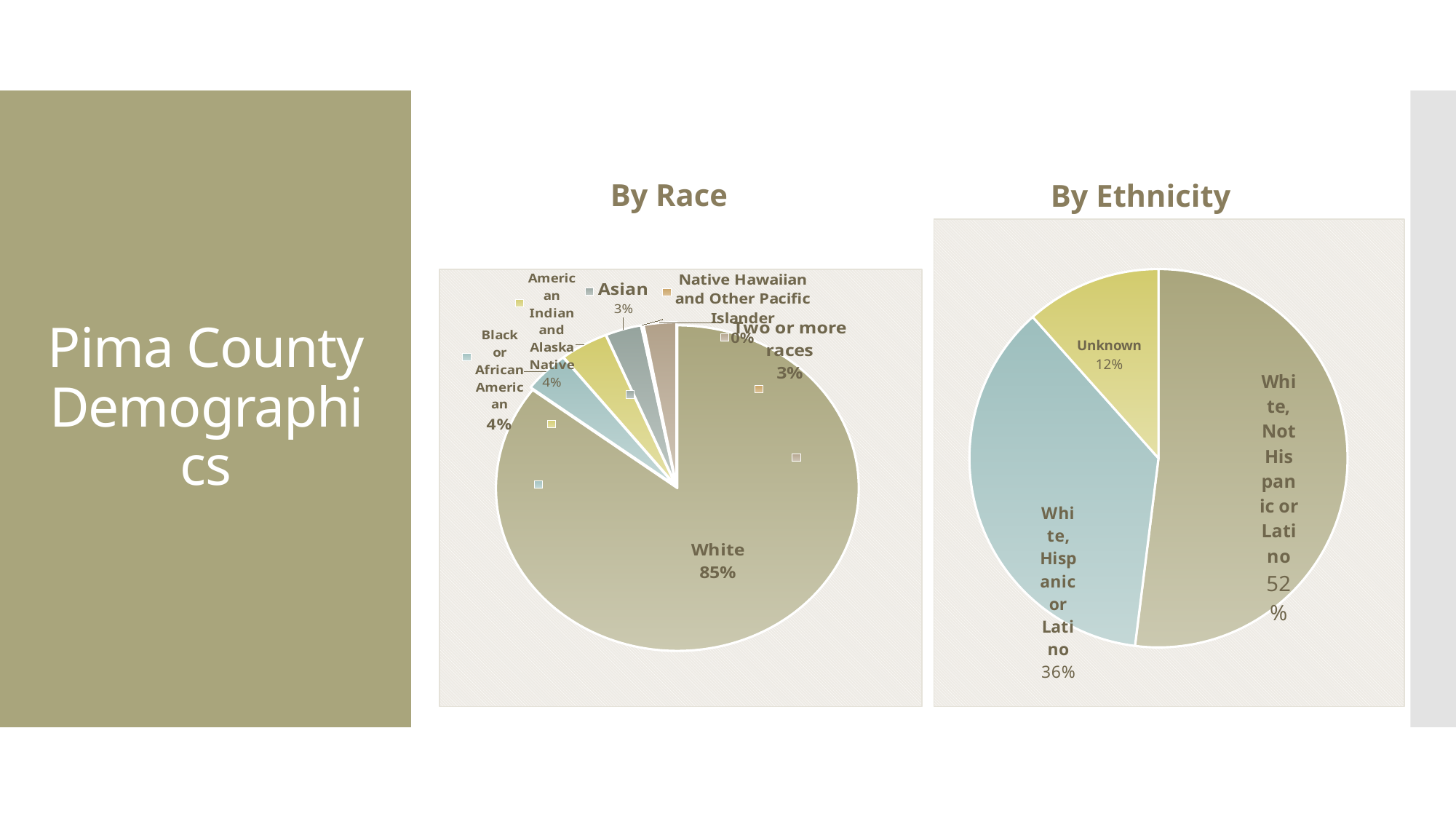
In the By Race chart, how many categories are shown? 6 In the By Race chart, what percentage is shown for Native Hawaiian and Other Pacific Islander? 0% In the By Ethnicity chart, what percentage is shown for Unknown? 12% In the By Ethnicity chart, what share of the pie is White, Hispanic or Latino? 36% In the By Race chart, what share of the pie is White? 85% What kind of chart is the By Ethnicity chart? Pie chart In the By Race chart, what percentage is shown for Asian? 3% In the By Ethnicity chart, what is the difference between White, Not Hispanic or Latino and White, Hispanic or Latino? 16% In the By Ethnicity chart, which category has the largest slice? White, Not Hispanic or Latino In the By Race chart, which category has the largest slice? White In the By Ethnicity chart, how many categories are shown? 3 In the By Race chart, which category has the smallest slice? Native Hawaiian and Other Pacific Islander